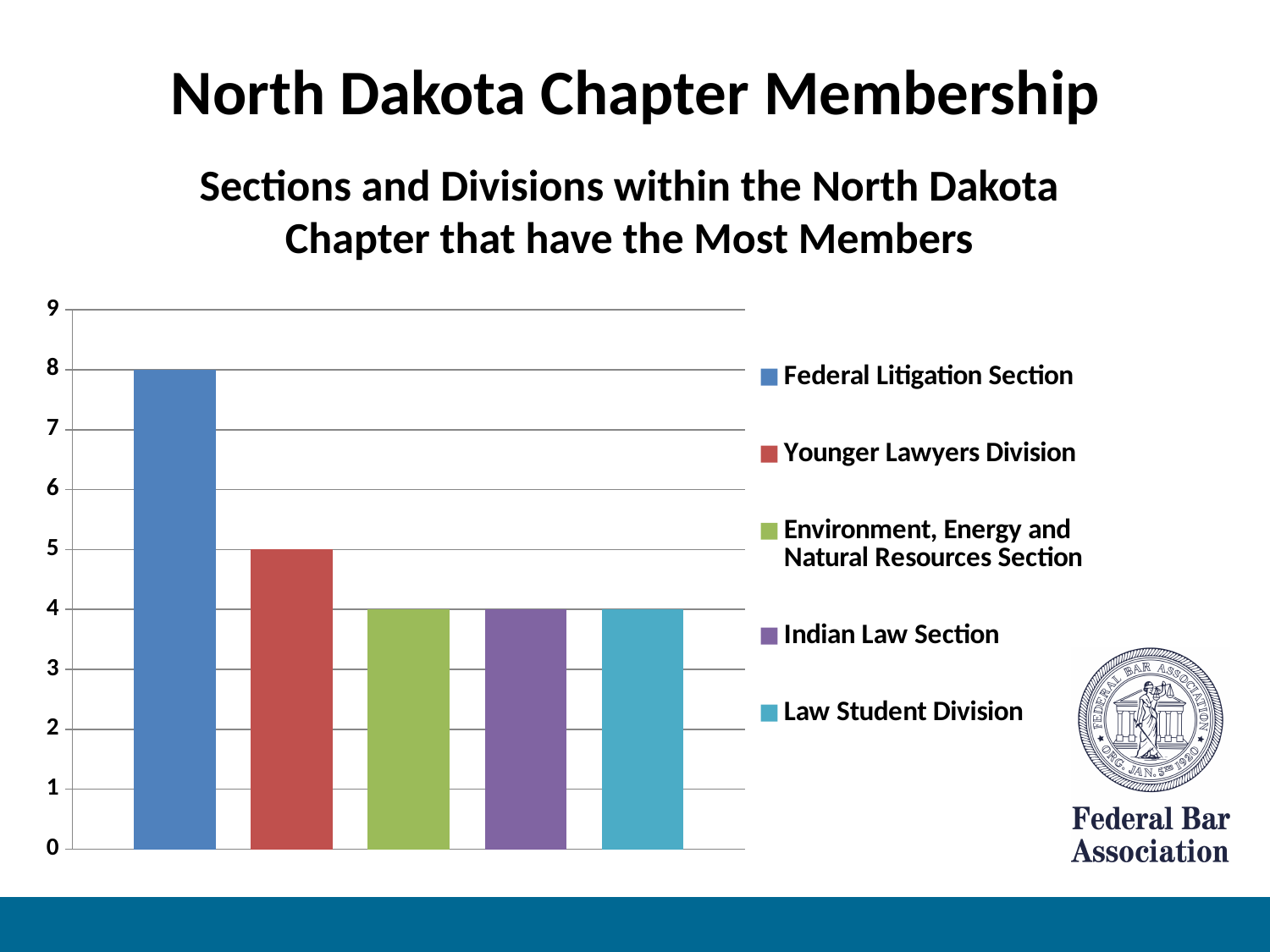
What is the value for the Federal Litigation Section? 8 What is the value for the Younger Lawyers Division? 5 What is the value for the Law Student Division? 4 Which is larger, the Younger Lawyers Division or the Environment, Energy and Natural Resources Section? Younger Lawyers Division What is the difference between the Federal Litigation Section and the Younger Lawyers Division? 3 What kind of chart is shown on the slide? bar chart What colour is the bar for the Federal Litigation Section? blue Is the value for the Federal Litigation Section greater or less than 6? greater Which section or division has the highest value? Federal Litigation Section How many series does the legend list? 5 What is the value for the Indian Law Section? 4 How many bars are plotted in the chart? 5